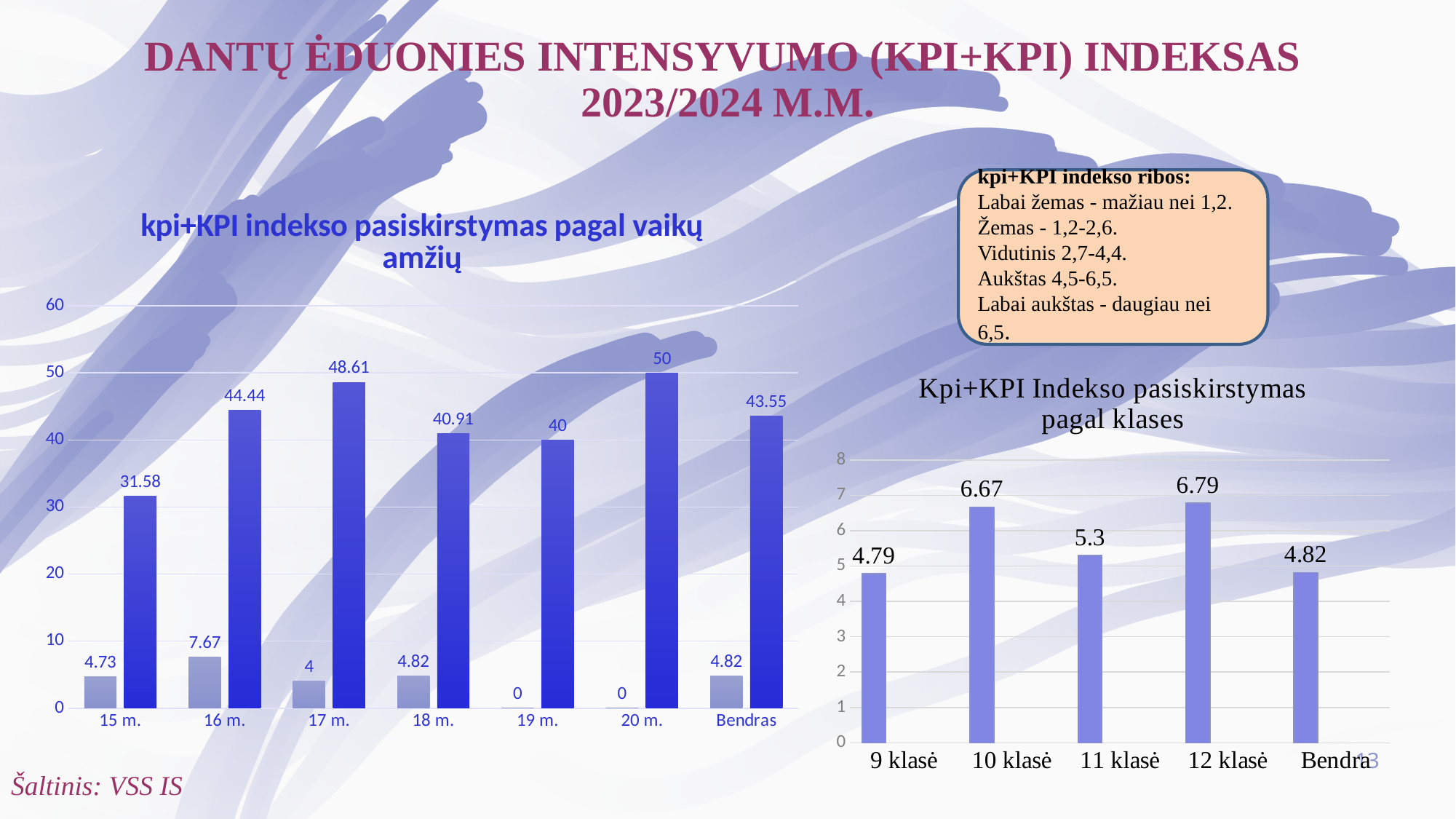
In the chart 'Kpi+KPI Indekso pasiskirstymas pagal klases', is the value for 11 klasė greater or less than 5? greater In the chart 'kpi+KPI indekso pasiskirstymas pagal vaikų amžių', what is the value of the shorter (grey) bar for 16 m.? 7.67 What type of chart is 'Kpi+KPI Indekso pasiskirstymas pagal klases'? bar chart In the chart 'kpi+KPI indekso pasiskirstymas pagal vaikų amžių', which is larger: the taller (blue) bar for 16 m. or for 18 m.? 16 m. In the chart 'kpi+KPI indekso pasiskirstymas pagal vaikų amžių', what is the value of the taller (blue) bar for 17 m.? 48.61 In the chart 'Kpi+KPI Indekso pasiskirstymas pagal klases', what is the value for 10 klasė? 6.67 In the chart 'Kpi+KPI Indekso pasiskirstymas pagal klases', which class has the highest value? 12 klasė In the chart 'kpi+KPI indekso pasiskirstymas pagal vaikų amžių', what is the difference between the taller (blue) bar values for 20 m. and 15 m.? 18.42 In the chart 'kpi+KPI indekso pasiskirstymas pagal vaikų amžių', which age group has the highest value among the taller (blue) bars? 20 m. In the chart 'Kpi+KPI Indekso pasiskirstymas pagal klases', how many categories are shown on the x axis? 5 In the chart 'Kpi+KPI Indekso pasiskirstymas pagal klases', what is the difference between the values for 12 klasė and 9 klasė? 2 In the chart 'Kpi+KPI Indekso pasiskirstymas pagal klases', which category has the lowest value? 9 klasė